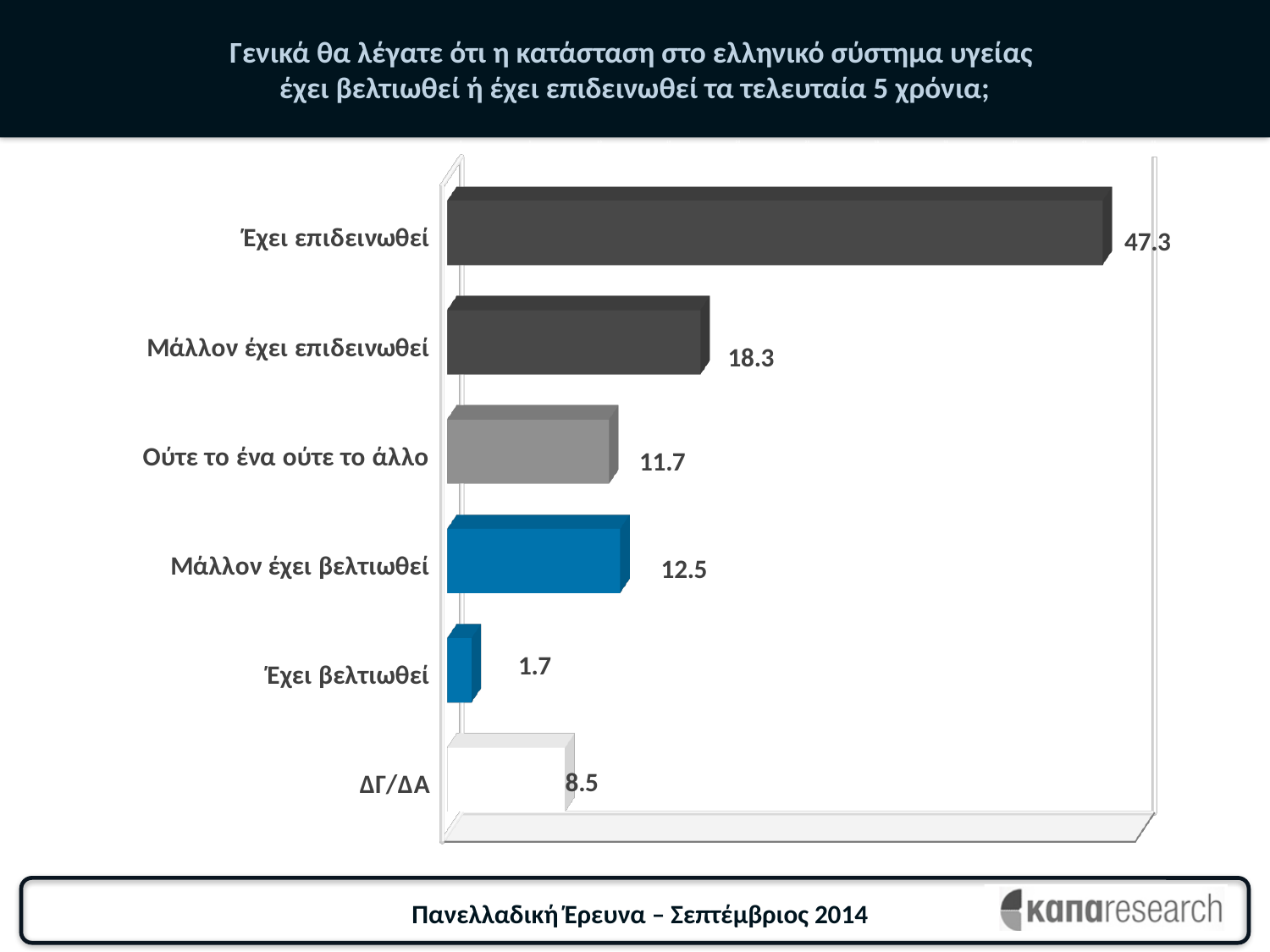
What is the difference between the values for 'Έχει επιδεινωθεί' and 'Μάλλον έχει επιδεινωθεί'? 29.0 What kind of chart is shown on the slide? Bar chart What is the value for 'Ούτε το ένα ούτε το άλλο'? 11.7 What is the value for 'Έχει επιδεινωθεί'? 47.3 Which category has the lowest value? Έχει βελτιωθεί Which is larger, the value for 'Μάλλον έχει βελτιωθεί' or 'Ούτε το ένα ούτε το άλλο'? Μάλλον έχει βελτιωθεί What is the value for 'Μάλλον έχει επιδεινωθεί'? 18.3 What is the value for 'ΔΓ/ΔΑ'? 8.5 What is the value for 'Έχει βελτιωθεί'? 1.7 Which category has the highest value? Έχει επιδεινωθεί What is the value for 'Μάλλον έχει βελτιωθεί'? 12.5 How many categories are shown in the chart? 6